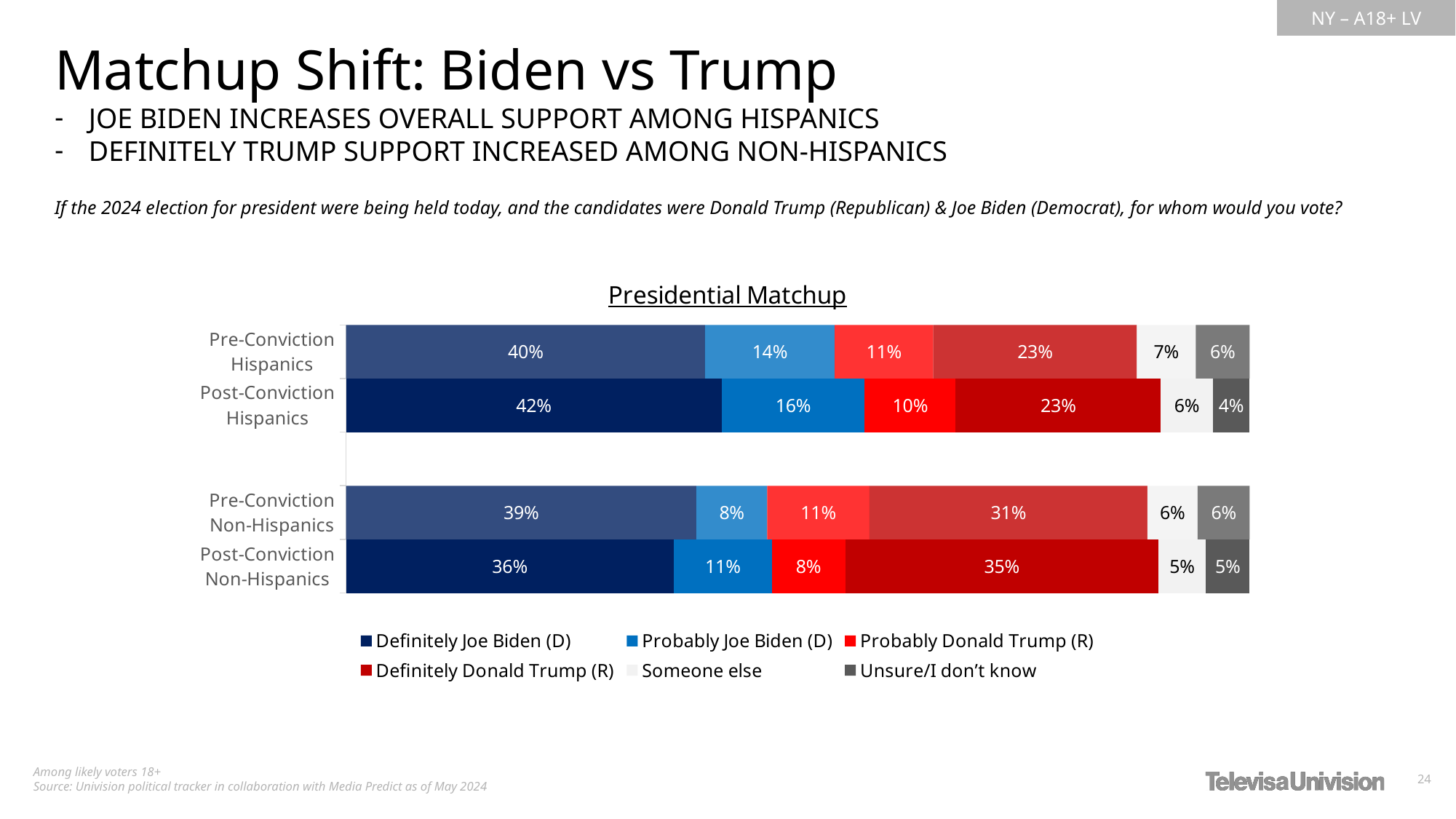
What is the title of the chart? Presidential Matchup What type of chart is used to show the Presidential Matchup? Stacked bar chart Which group has the highest Definitely Joe Biden (D) share? Post-Conviction Hispanics How many series does the legend list? 6 Which is larger: Probably Joe Biden (D) among Pre-Conviction Hispanics or among Post-Conviction Hispanics? Post-Conviction Hispanics What is the Unsure/I don't know value for Pre-Conviction Hispanics? 6% What is the difference in Definitely Joe Biden (D) support between Pre-Conviction Non-Hispanics and Post-Conviction Non-Hispanics? 3 percentage points What percentage of Post-Conviction Non-Hispanics chose Definitely Donald Trump (R)? 35% What percentage of Post-Conviction Hispanics chose Definitely Joe Biden (D)? 42% How many groups (bars) are shown in the Presidential Matchup chart? 4 By how many percentage points did Definitely Donald Trump (R) support among Non-Hispanics change from Pre-Conviction to Post-Conviction? 4 percentage points Which group has the lowest Probably Joe Biden (D) share? Pre-Conviction Non-Hispanics